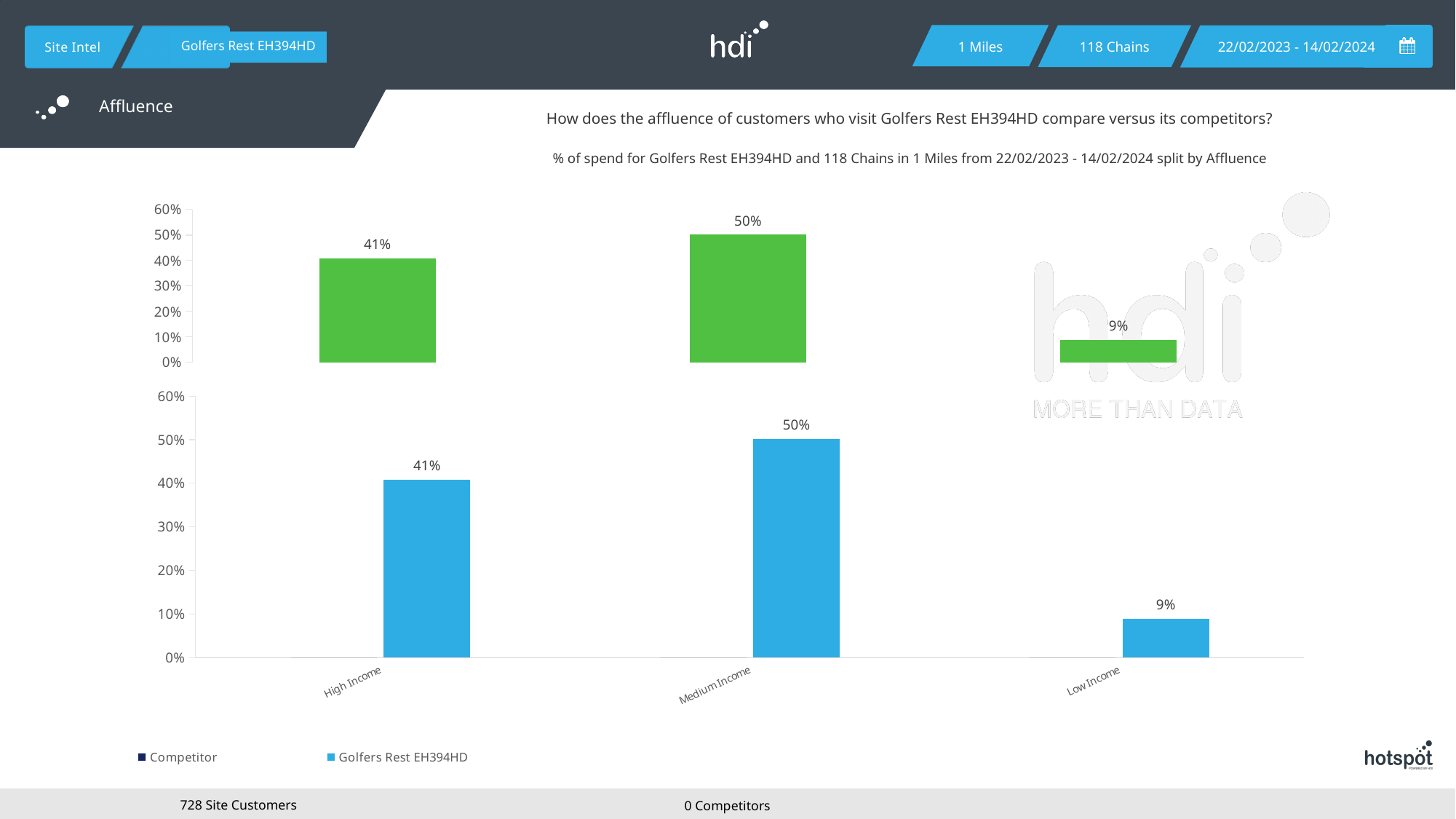
In the bottom chart, which category has the lowest value? Low Income In the bottom chart, how many categories are shown on the x axis? 3 In the bottom chart, which category has the highest value? Medium Income What kind of chart is the bottom chart? bar chart In the top chart, what is the value shown on the rightmost bar? 9% In the bottom chart, what is the value for Medium Income? 50% In the bottom chart, what is the value for High Income? 41% In the bottom chart, what is the value for Low Income? 9% How many series does the legend at the bottom of the slide list? 2 In the bottom chart, what is the difference between the Medium Income and High Income values? 9% In the top chart, what is the value shown on the middle bar? 50% In the bottom chart, which is larger, the value for High Income or the value for Low Income? High Income